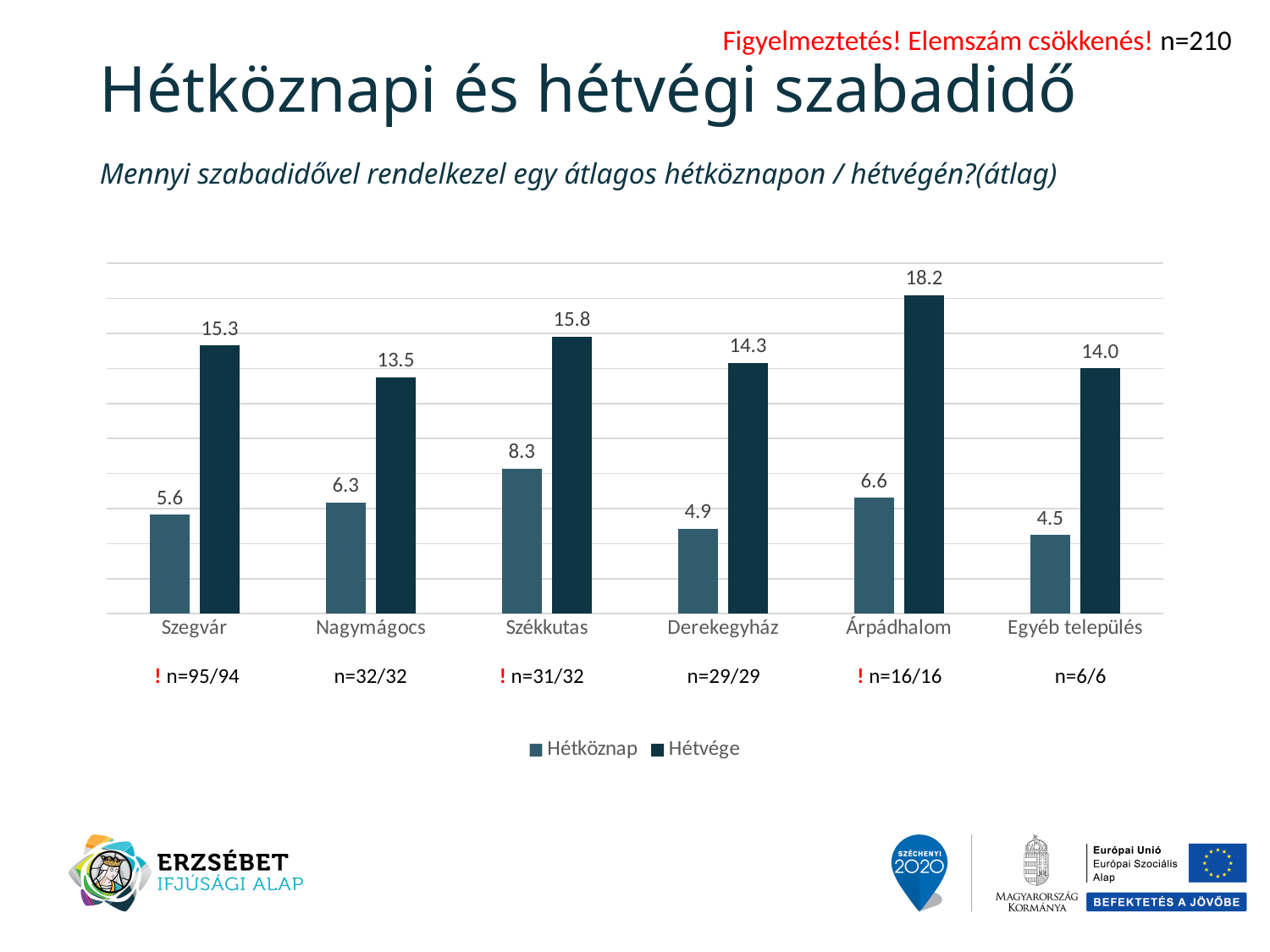
What is the Hétvége value for Egyéb település? 14.0 Which category has the highest Hétvége value? Árpádhalom How many series does the legend list? 2 Which category has the lowest Hétköznap value? Egyéb település What kind of chart is shown on the slide? bar chart What is the difference between the Hétvége values for Árpádhalom and Nagymágocs? 4.7 Which is larger: the Hétköznap value for Nagymágocs or the Hétköznap value for Derekegyház? Nagymágocs What is the Hétvége value for Árpádhalom? 18.2 What is the Hétköznap value for Székkutas? 8.3 What is the difference between the Hétvége and Hétköznap values for Szegvár? 9.7 How many categories are shown on the x axis? 6 What are the two series named in the legend? Hétköznap and Hétvége